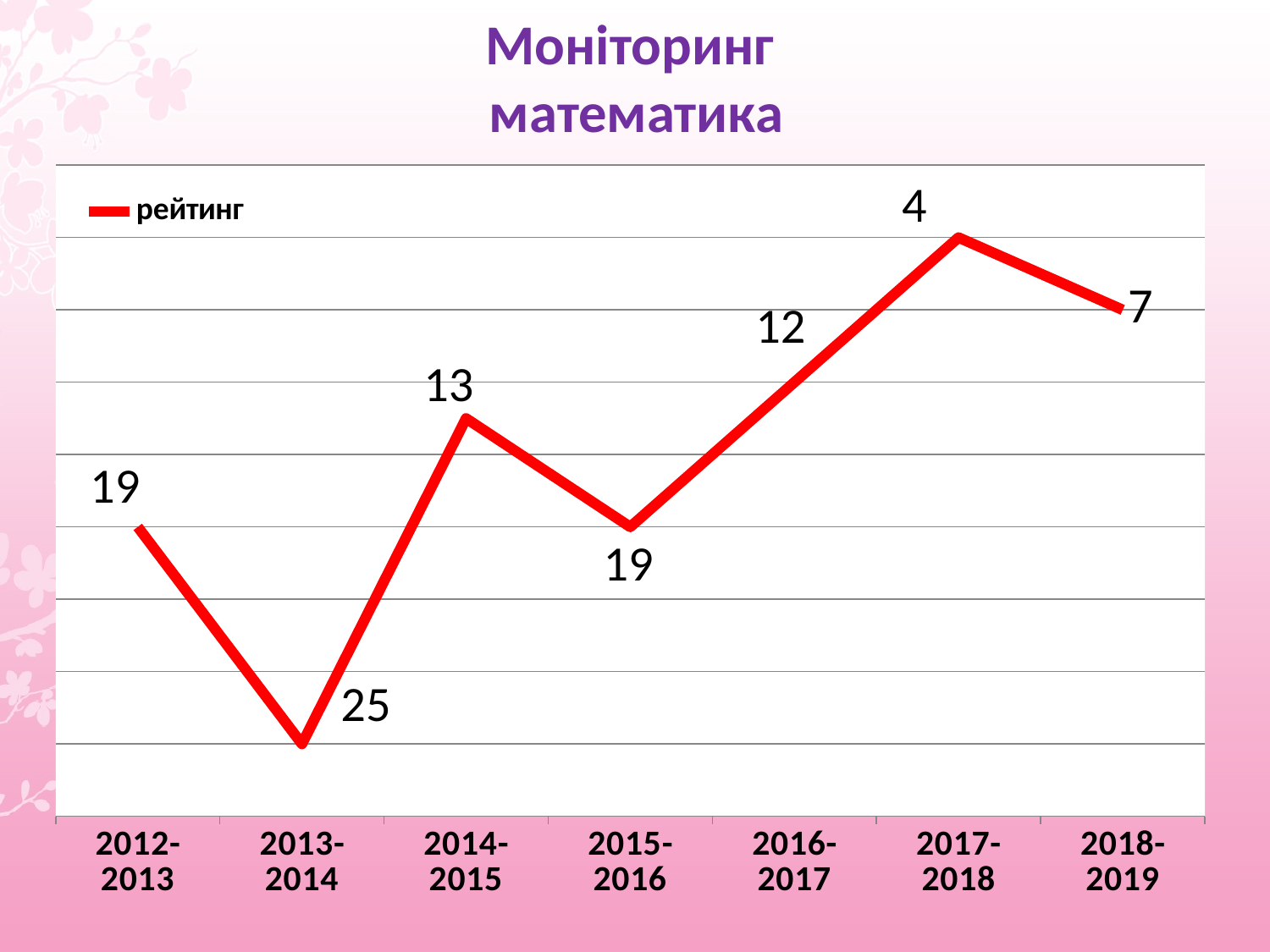
What is the рейтинг value for 2013-2014? 25 What is the рейтинг value for 2018-2019? 7 What kind of chart is shown on the slide? line chart What is the рейтинг value for 2016-2017? 12 How many years are plotted on the chart? 7 What is the рейтинг value for 2017-2018? 4 What is the difference between the рейтинг values for 2018-2019 and 2017-2018? 3 What is the difference between the рейтинг values for 2013-2014 and 2014-2015? 12